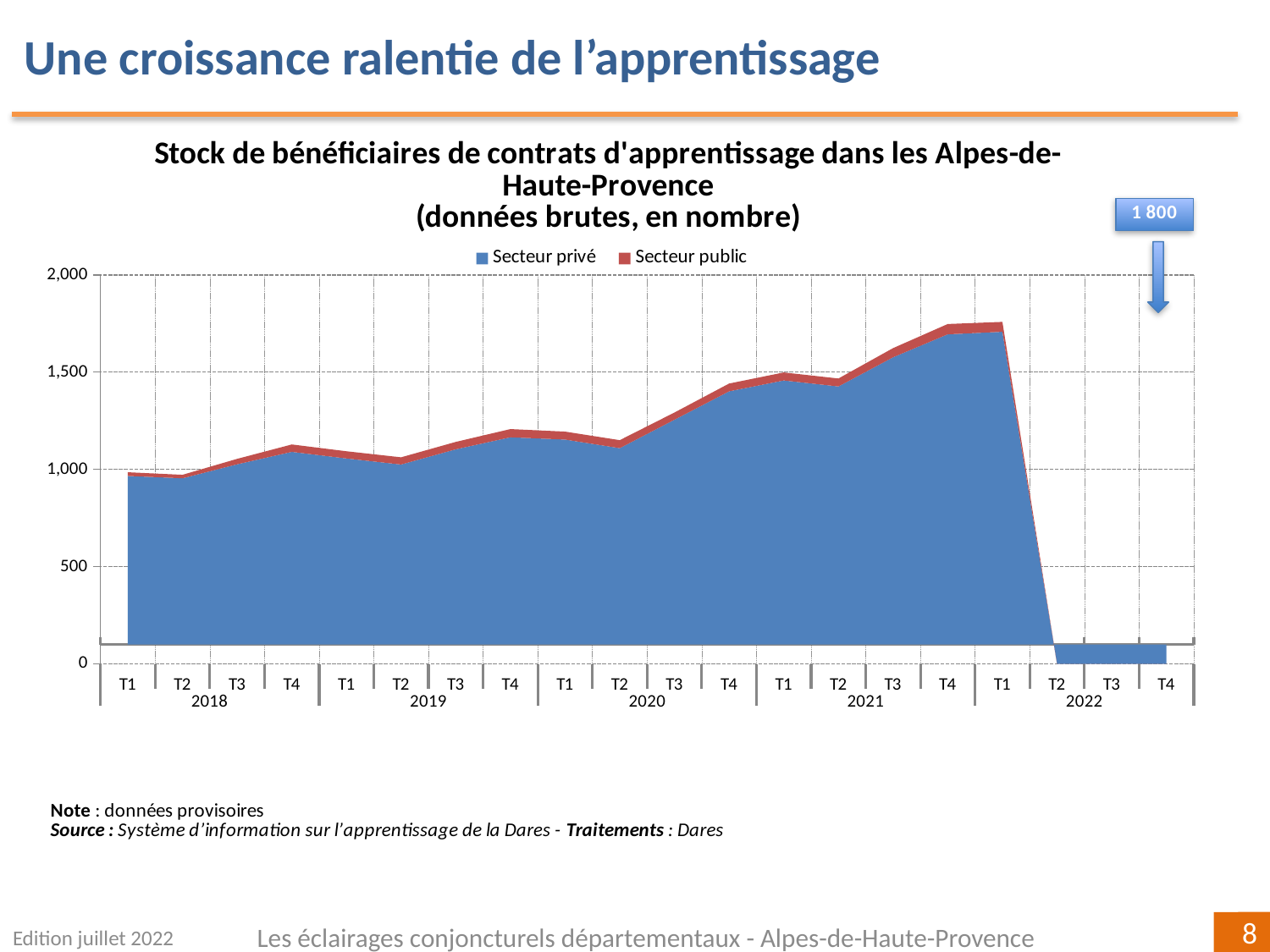
Is the total stock in T4 2021 greater or less than 2,000? less How many years are labelled along the x axis of the chart? 5 What kind of chart is shown on the slide? Area chart Is the total stock in T4 2021 greater or less than 1,500? greater Does the total stock generally rise or fall from T1 2018 to T4 2021? rise Which is larger, the total stock in T4 2020 or in T4 2018? T4 2020 How many series does the chart legend list? 2 What are the two series named in the chart legend? Secteur privé and Secteur public How many quarters are labelled along the x axis of the chart? 20 Is the total stock in T4 2019 greater or less than 1,000? greater Which series accounts for the larger part of the stacked area, Secteur privé or Secteur public? Secteur privé